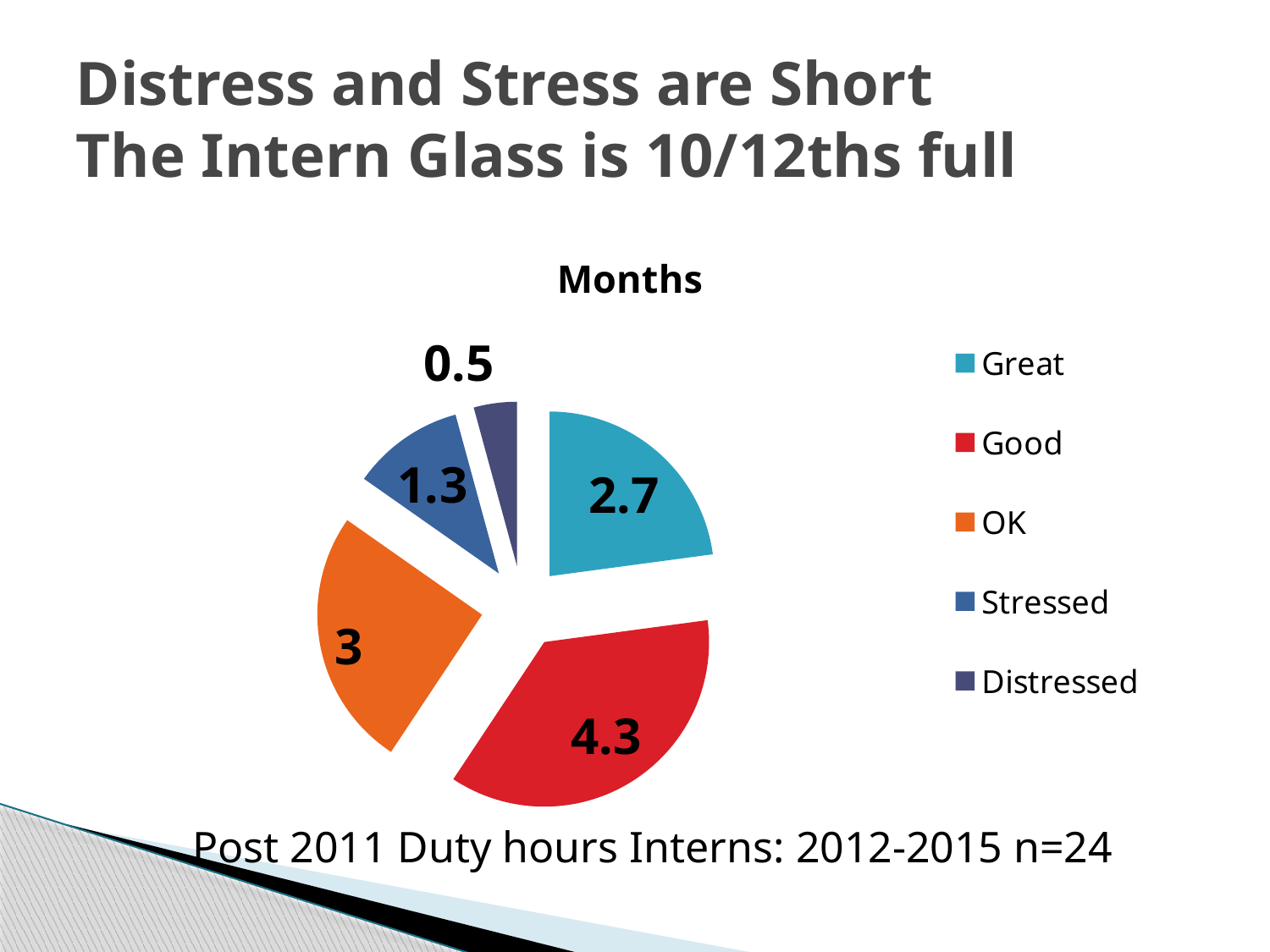
What is the difference between the values for Good and OK? 1.3 What is the title of the chart? Months How many slices does the pie chart have? 5 What is the value for Distressed? 0.5 Which category has the largest slice? Good How many entries does the legend list? 5 What is the value for Stressed? 1.3 What is the value for Good? 4.3 What is the value for Great? 2.7 What type of chart is shown on the slide? pie chart Which is larger, the value for Great or the value for OK? OK Which category has the smallest slice? Distressed